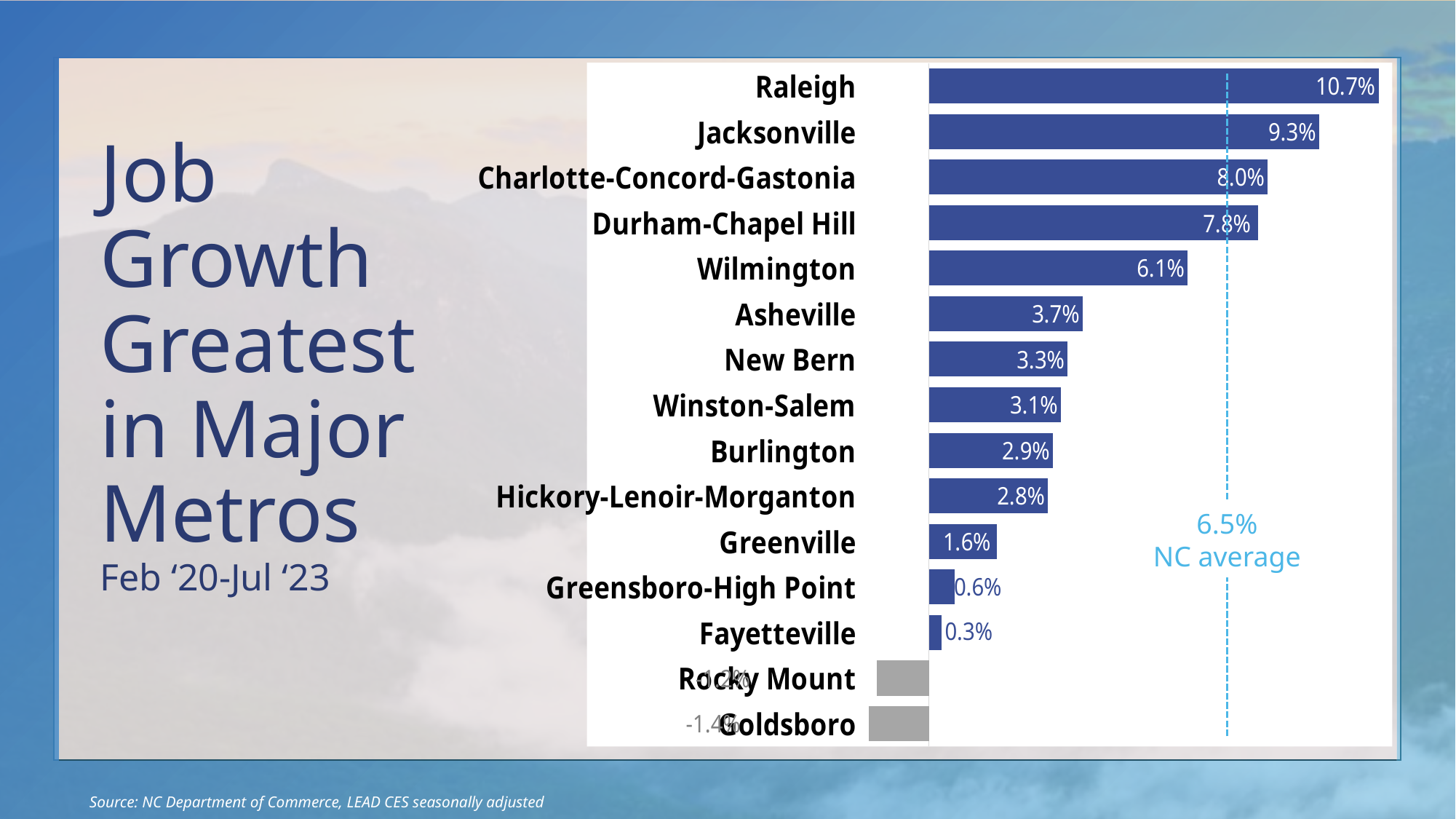
Which has higher job growth, Asheville or New Bern? Asheville What is the job growth value for Raleigh? 10.7% What is the difference in job growth between Raleigh and Jacksonville? 1.4% What is the job growth value for Hickory-Lenoir-Morganton? 2.8% What is the job growth value for Wilmington? 6.1% What is the difference in job growth between Charlotte-Concord-Gastonia and Durham-Chapel Hill? 0.2% What value does the dashed reference line labelled NC average mark? 6.5% Which metro has the highest job growth? Raleigh What is the job growth value for Fayetteville? 0.3% Which has higher job growth, Greenville or Greensboro-High Point? Greenville How many metros are shown in the chart? 15 What kind of chart is shown on the slide? Bar chart